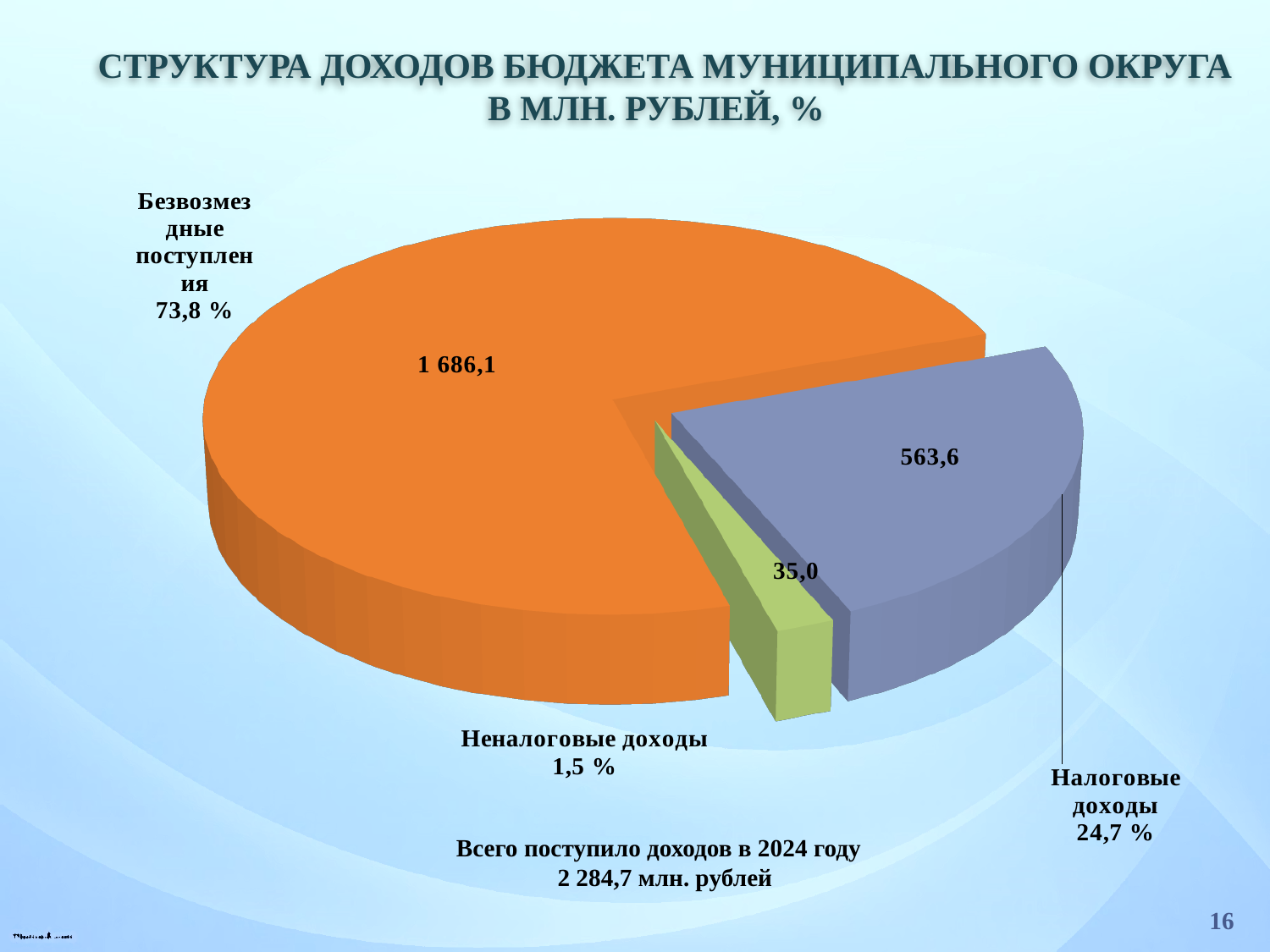
What is the value for Неналоговые доходы in the pie chart? 35,0 What is the value for Безвозмездные поступления in the pie chart? 1 686,1 Which category has the largest slice in the pie chart? Безвозмездные поступления Which is larger, Налоговые доходы or Неналоговые доходы? Налоговые доходы What kind of chart is shown on the slide? Pie chart What share of the pie does Неналоговые доходы represent? 1,5 % What share of the pie does Налоговые доходы represent? 24,7 % What share of the pie does Безвозмездные поступления represent? 73,8 % How many slices does the pie chart have? 3 Which category has the smallest slice in the pie chart? Неналоговые доходы What is the difference between the values for Безвозмездные поступления and Налоговые доходы? 1 122,5 What is the value for Налоговые доходы in the pie chart? 563,6